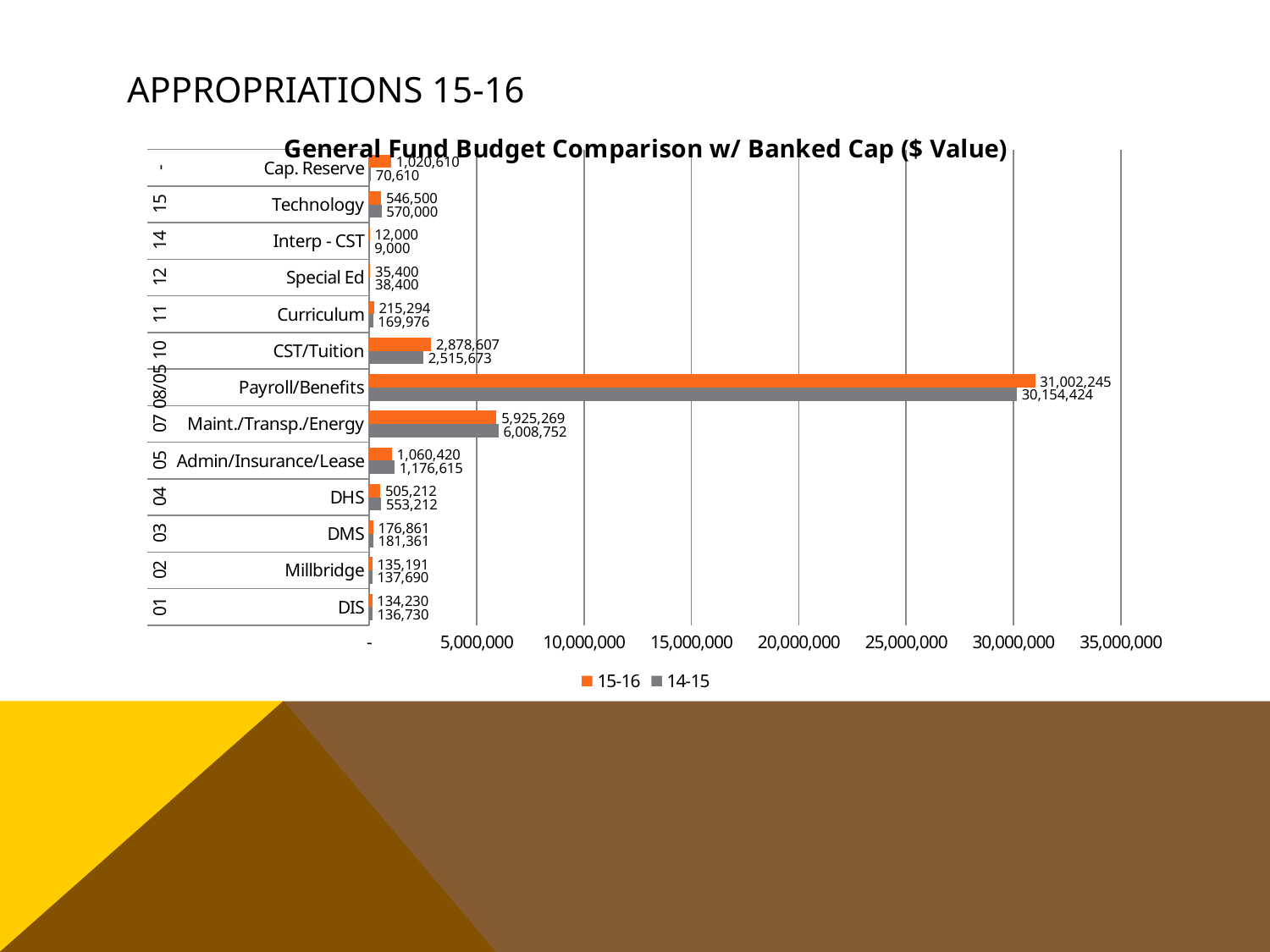
How many categories are shown on the chart? 13 What is the difference between the 15-16 and 14-15 values for Payroll/Benefits? 847,821 How many series does the legend list? 2 What is the difference between the 14-15 and 15-16 values for DHS? 48,000 What is the 15-16 value for Payroll/Benefits? 31,002,245 What is the 14-15 value for CST/Tuition? 2,515,673 Which category has the lowest 14-15 value? Interp - CST Which category has the highest 15-16 value? Payroll/Benefits What kind of chart is shown on the slide? Bar chart Which is larger for Technology, the 15-16 value or the 14-15 value? 14-15 What is the 15-16 value for Cap. Reserve? 1,020,610 What is the 14-15 value for Maint./Transp./Energy? 6,008,752